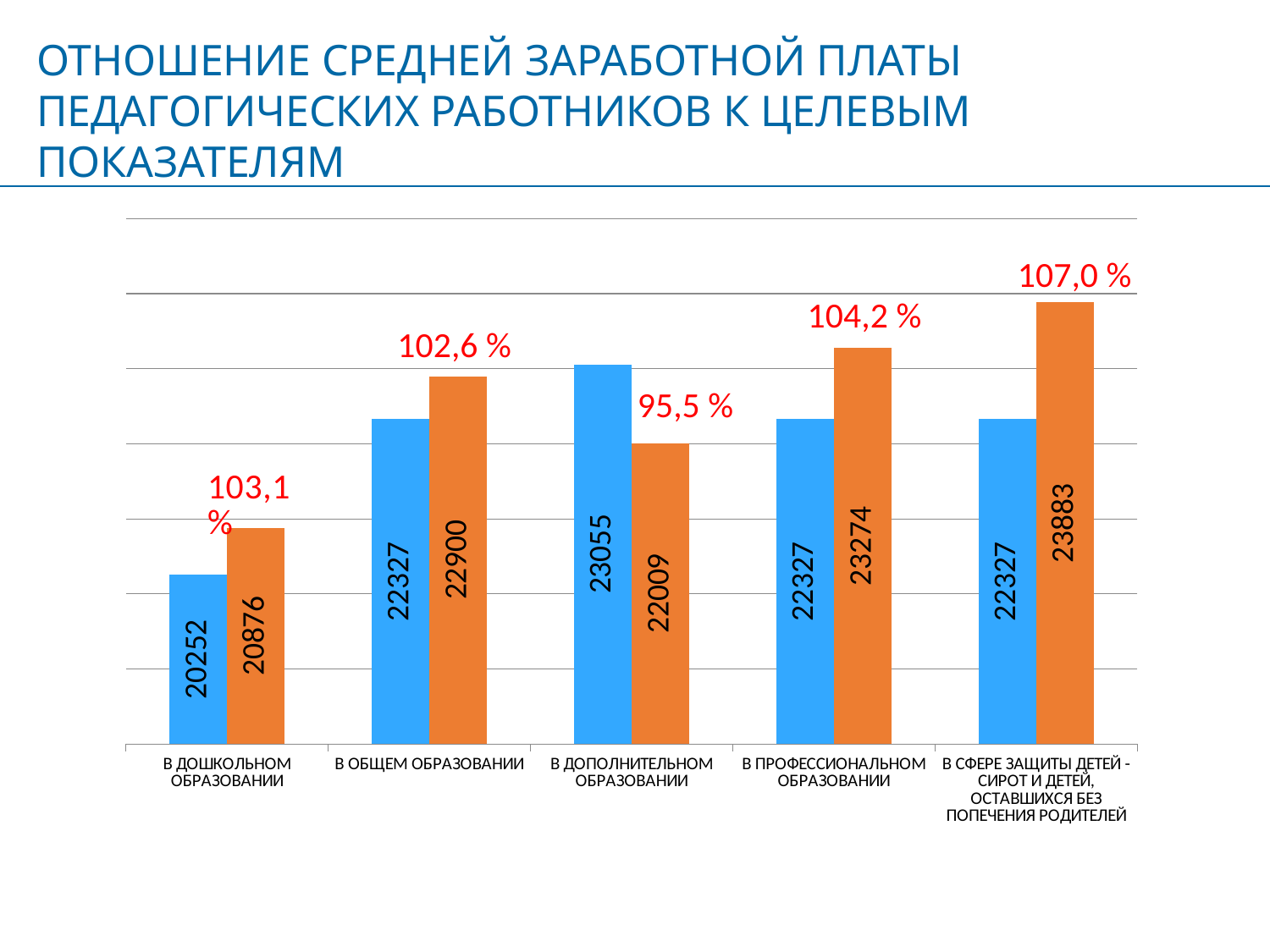
Which category has the highest orange bar? В сфере защиты детей-сирот и детей, оставшихся без попечения родителей What is the value of the orange bar for "В дополнительном образовании"? 22009 Which category has the lowest blue bar? В дошкольном образовании Which category has the lowest percentage shown above its bars? В дополнительном образовании What is the value of the orange bar for "В профессиональном образовании"? 23274 What is the value of the blue bar for "В дошкольном образовании"? 20252 How many categories are shown on the x axis of the chart? 5 For "В дополнительном образовании", which bar is larger, the blue or the orange one? Blue What percentage is shown for "В общем образовании"? 102,6 % What type of chart is shown on the slide? Bar chart What is the difference between the orange and blue bars for "В сфере защиты детей-сирот и детей, оставшихся без попечения родителей"? 1556 What percentage is shown above the bars for "В сфере защиты детей-сирот и детей, оставшихся без попечения родителей"? 107,0 %